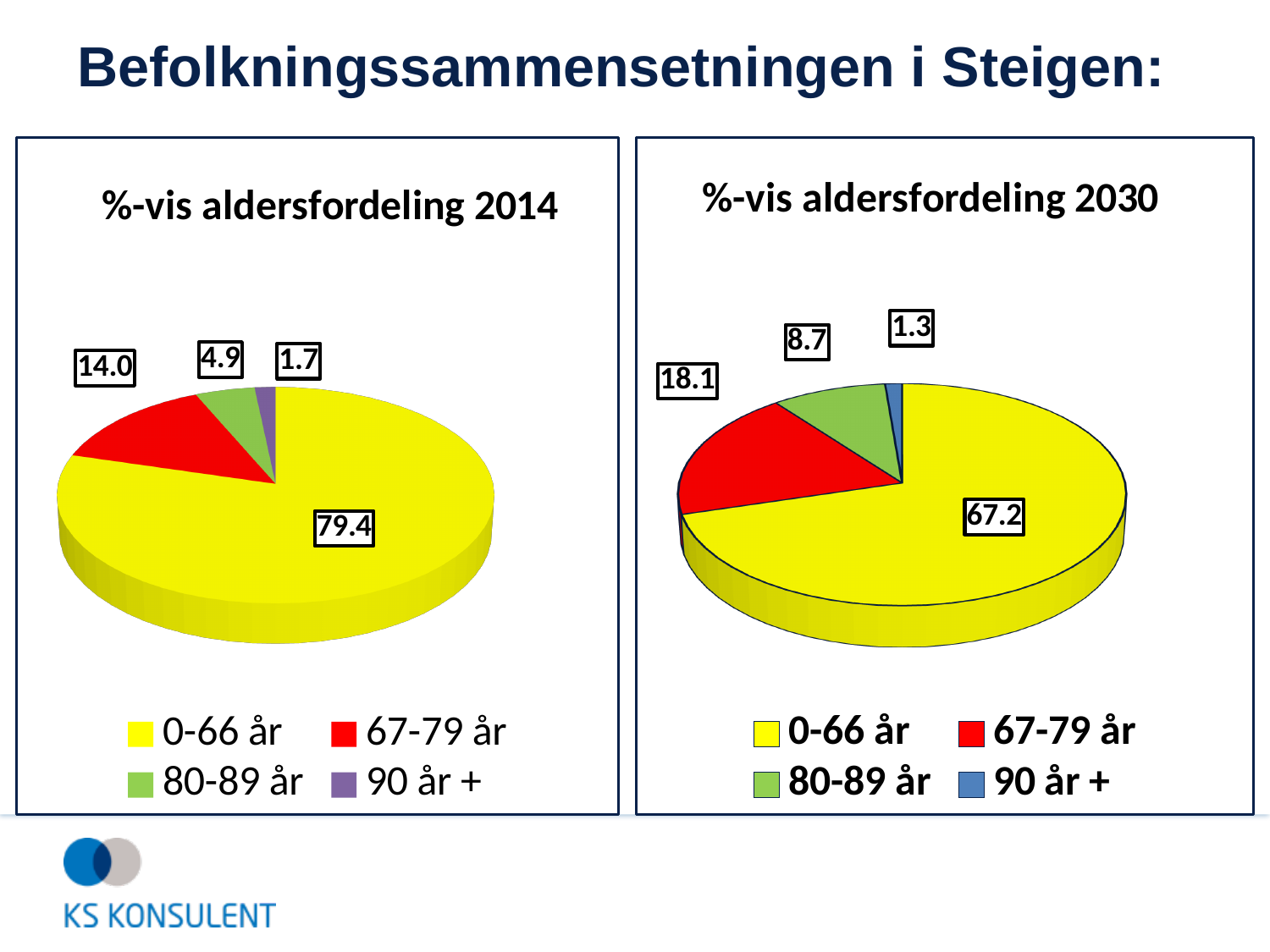
Which is larger: the value for 67-79 år in the 2014 chart or the value for 67-79 år in the 2030 chart? 2030 chart In the chart titled '%-vis aldersfordeling 2014', what is the value for 67-79 år? 14.0 How many categories does the chart titled '%-vis aldersfordeling 2014' show? 4 In the chart titled '%-vis aldersfordeling 2014', what colour is the slice for 80-89 år? Green In the chart titled '%-vis aldersfordeling 2030', which category has the largest slice? 0-66 år What kind of chart is '%-vis aldersfordeling 2030'? Pie chart In the chart titled '%-vis aldersfordeling 2030', what is the value for 80-89 år? 8.7 In the chart titled '%-vis aldersfordeling 2030', what is the value for 90 år +? 1.3 In the chart titled '%-vis aldersfordeling 2030', what is the difference between the values for 67-79 år and 80-89 år? 9.4 What is the title of the chart on the right side of the slide? %-vis aldersfordeling 2030 In the chart titled '%-vis aldersfordeling 2014', what is the value for 0-66 år? 79.4 In the chart titled '%-vis aldersfordeling 2014', which category has the smallest slice? 90 år +